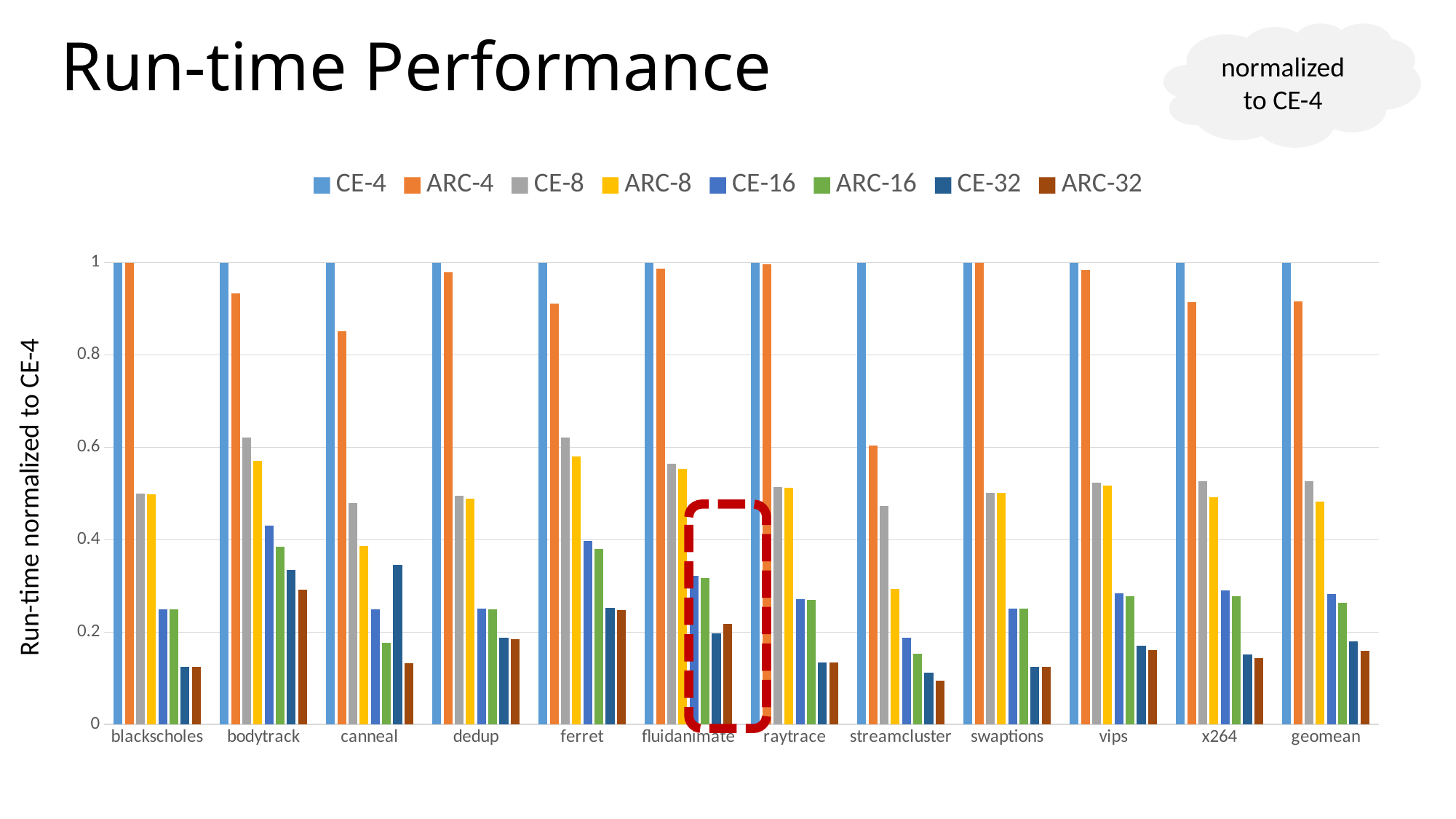
Which series has the lowest value for canneal? ARC-32 What kind of chart is shown on the slide? bar chart For canneal, which is larger: the CE-8 value or the ARC-8 value? CE-8 Is the ARC-4 value for canneal greater or less than 0.8? greater Is the CE-32 value for canneal greater or less than 0.3? greater Which category is highlighted with a dashed red box? fluidanimate Which category has the lowest ARC-4 value? streamcluster How many categories are shown along the x axis? 12 Is the ARC-4 value for streamcluster greater or less than 0.8? less How many series does the legend list? 8 For ferret, which is larger: the CE-16 value or the CE-32 value? CE-16 What is the CE-4 value for blackscholes? 1